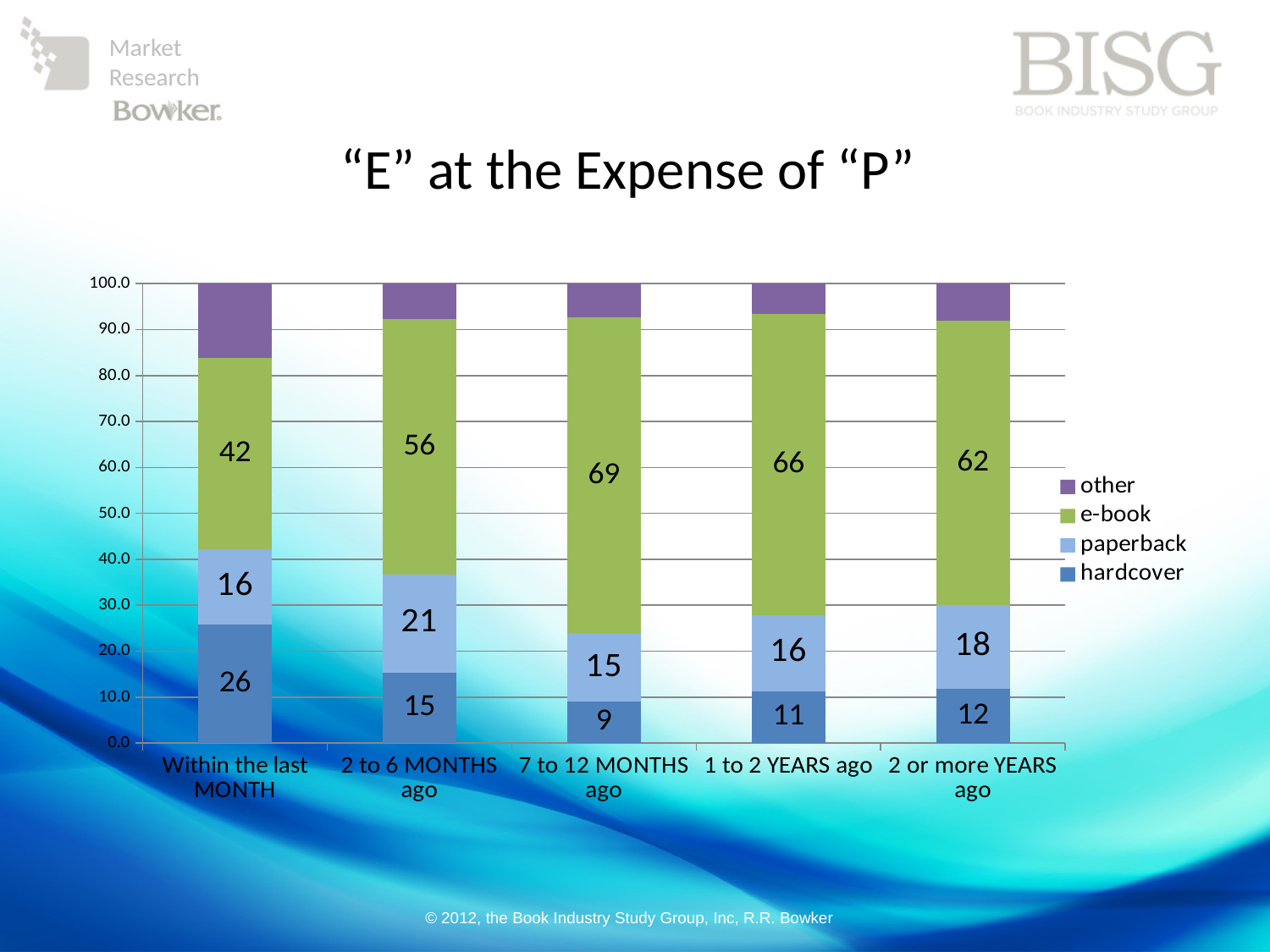
How many series does the legend list? 4 What is the hardcover value for the "1 to 2 YEARS ago" category? 11 What is the paperback value for the "2 to 6 MONTHS ago" category? 21 How many categories are shown on the x axis? 5 Which has the larger paperback value: "1 to 2 YEARS ago" or "2 or more YEARS ago"? 2 or more YEARS ago Which category has the lowest hardcover value? 7 to 12 MONTHS ago What is the e-book value for the "7 to 12 MONTHS ago" category? 69 What is the difference between the e-book value for "7 to 12 MONTHS ago" and the e-book value for "Within the last MONTH"? 27 What is the hardcover value for the "Within the last MONTH" category? 26 Which category has the highest e-book value? 7 to 12 MONTHS ago What kind of chart is shown on the slide? Stacked bar chart Is the value for "other" in the "Within the last MONTH" category greater or less than 10? greater